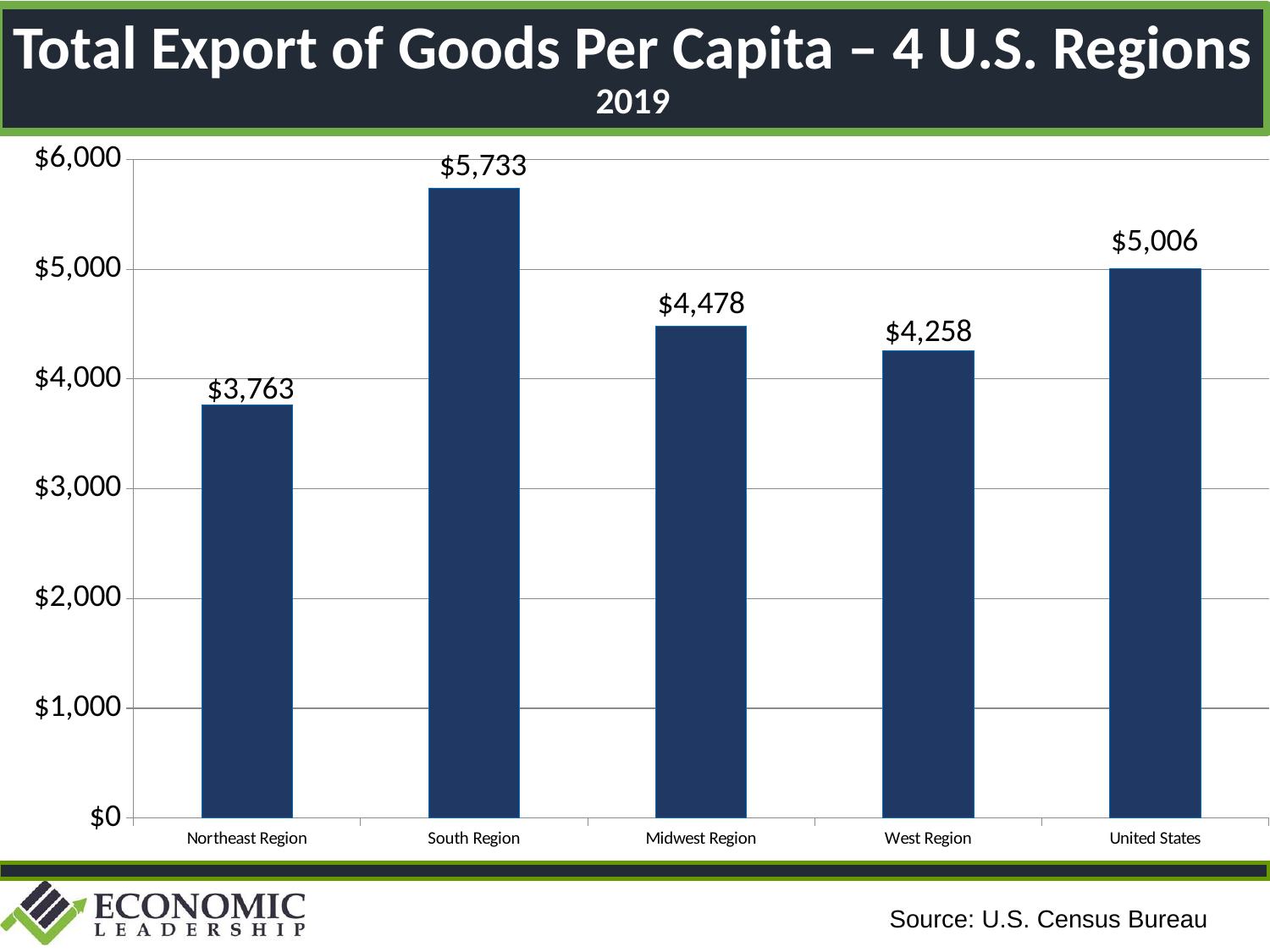
What is the value shown for the United States? $5,006 What is the difference between the Midwest Region and the West Region values? $220 What kind of chart is shown on the slide? Bar chart Which category has the highest export of goods per capita? South Region What is the total export of goods per capita for the Northeast Region? $3,763 Which is larger, the value for the Midwest Region or the West Region? Midwest Region What is the total export of goods per capita for the South Region? $5,733 How many categories are shown on the x axis? 5 What is the difference between the South Region and the Northeast Region values? $1,970 Is the value for the West Region greater or less than $4,000? greater What year does the chart title refer to? 2019 Which category has the lowest export of goods per capita? Northeast Region